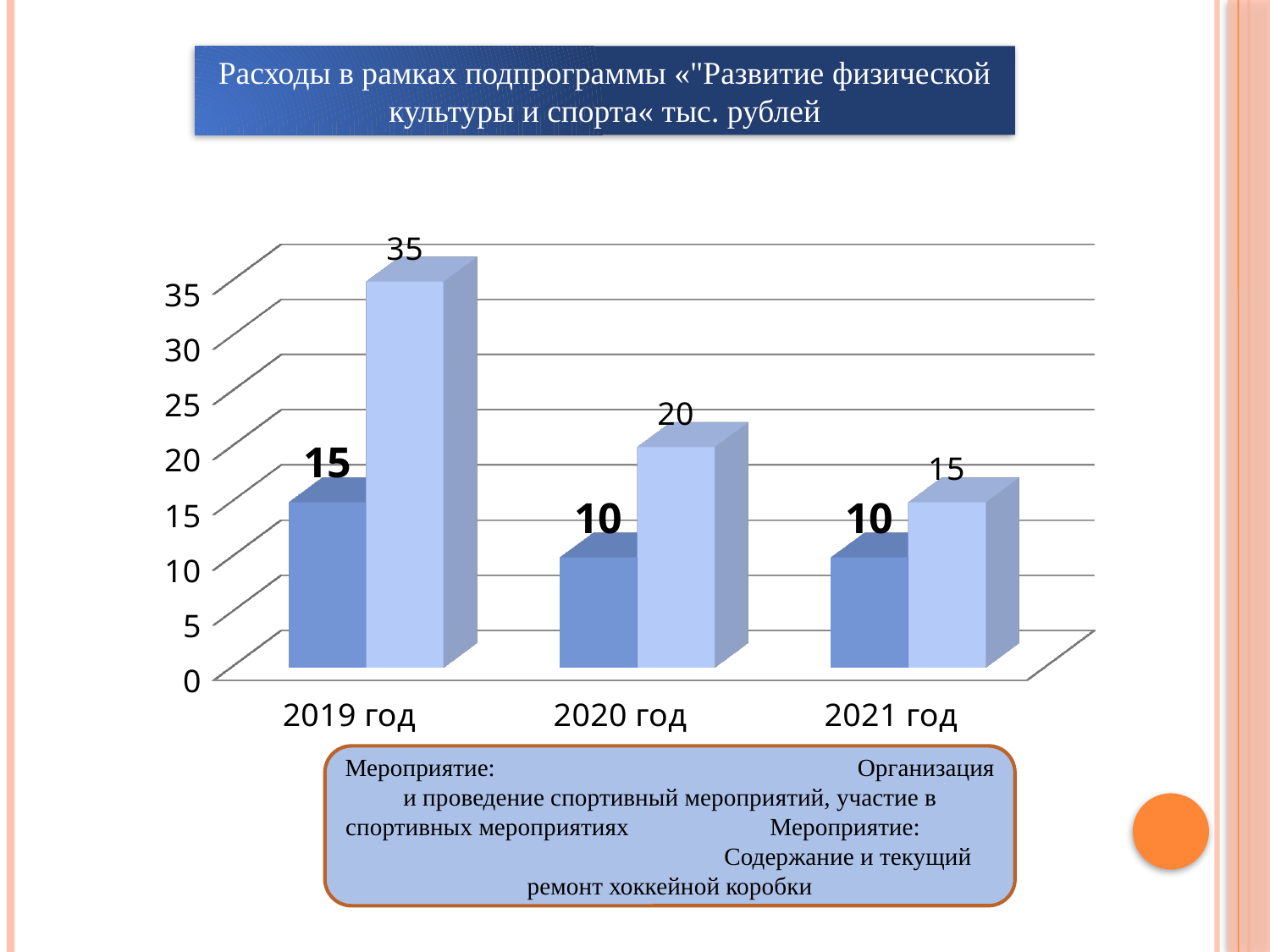
In which year is the light blue bar the lowest? 2021 год What kind of chart is shown on the slide? bar chart What is the value of the dark blue bar for 2021 год? 10 What is the combined value of the dark blue and light blue bars for 2020 год? 30 How many years are shown on the x axis? 3 What is the value of the light blue bar for 2020 год? 20 What is the value of the dark blue bar for 2019 год? 15 What is the value of the light blue bar for 2019 год? 35 In which year is the light blue bar the highest? 2019 год What is the difference between the light blue bar and the dark blue bar for 2019 год? 20 Do the light blue bars rise or fall from 2019 год to 2021 год? fall Which bar is larger for 2020 год, the dark blue bar or the light blue bar? the light blue bar